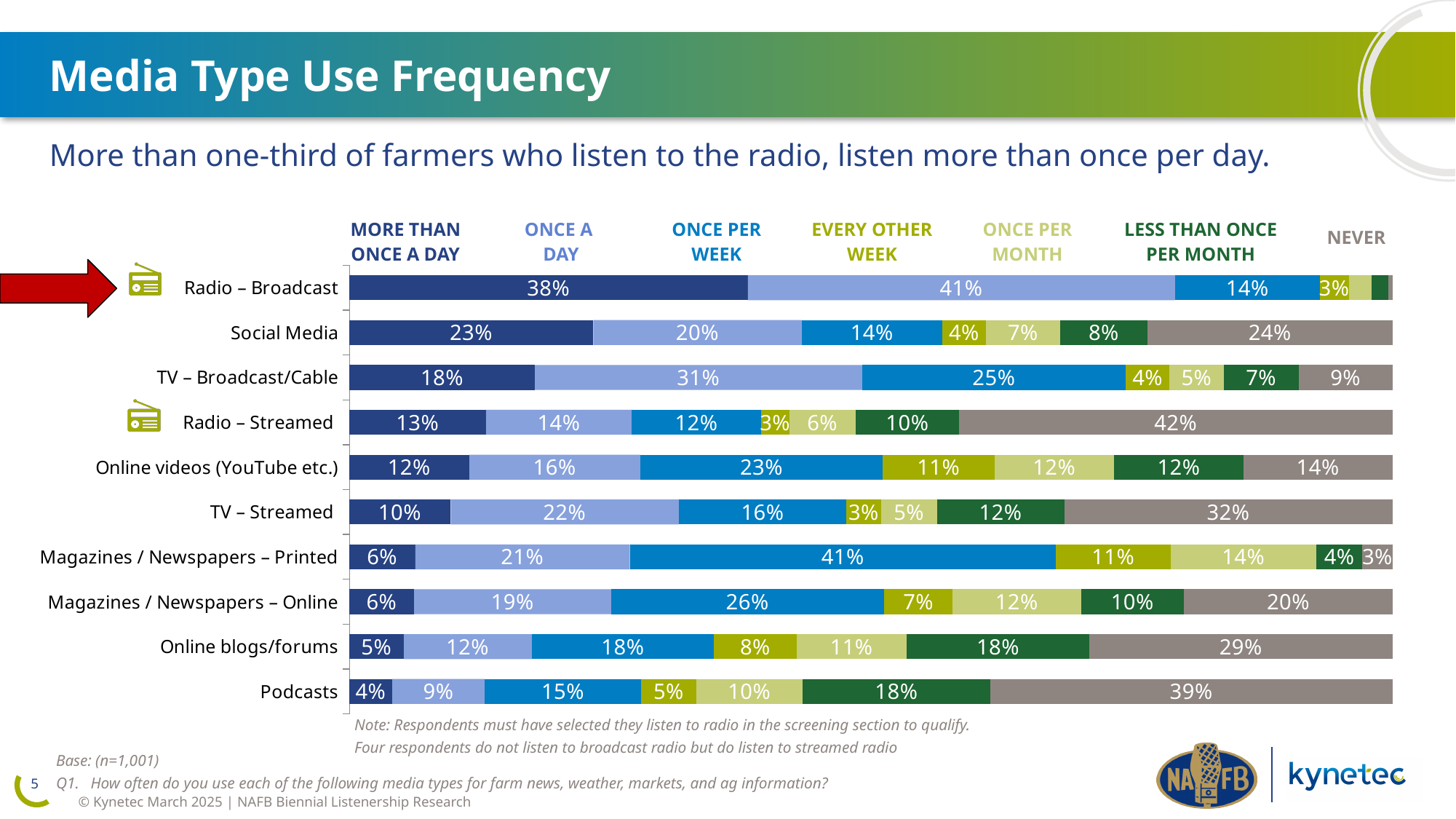
What percentage of farmers use TV – Broadcast/Cable once a day? 31% What percentage of farmers use Radio – Broadcast more than once a day? 38% What percentage of farmers never use Podcasts? 39% Which media type is marked with a red arrow on the slide? Radio – Broadcast How many media types are shown in the chart? 10 Which media type has the lowest 'More than once a day' percentage? Podcasts Which is larger: the 'Once per week' percentage for Online videos (YouTube etc.) or for Social Media? Online videos (YouTube etc.) What kind of chart is shown on the slide? Stacked bar chart What percentage of farmers use Magazines / Newspapers – Printed once per week? 41% What is the difference between the 'Never' percentages for Radio – Streamed and TV – Streamed? 10% Which media type has the highest 'Never' percentage? Radio – Streamed How many frequency categories does the chart's legend list? 7